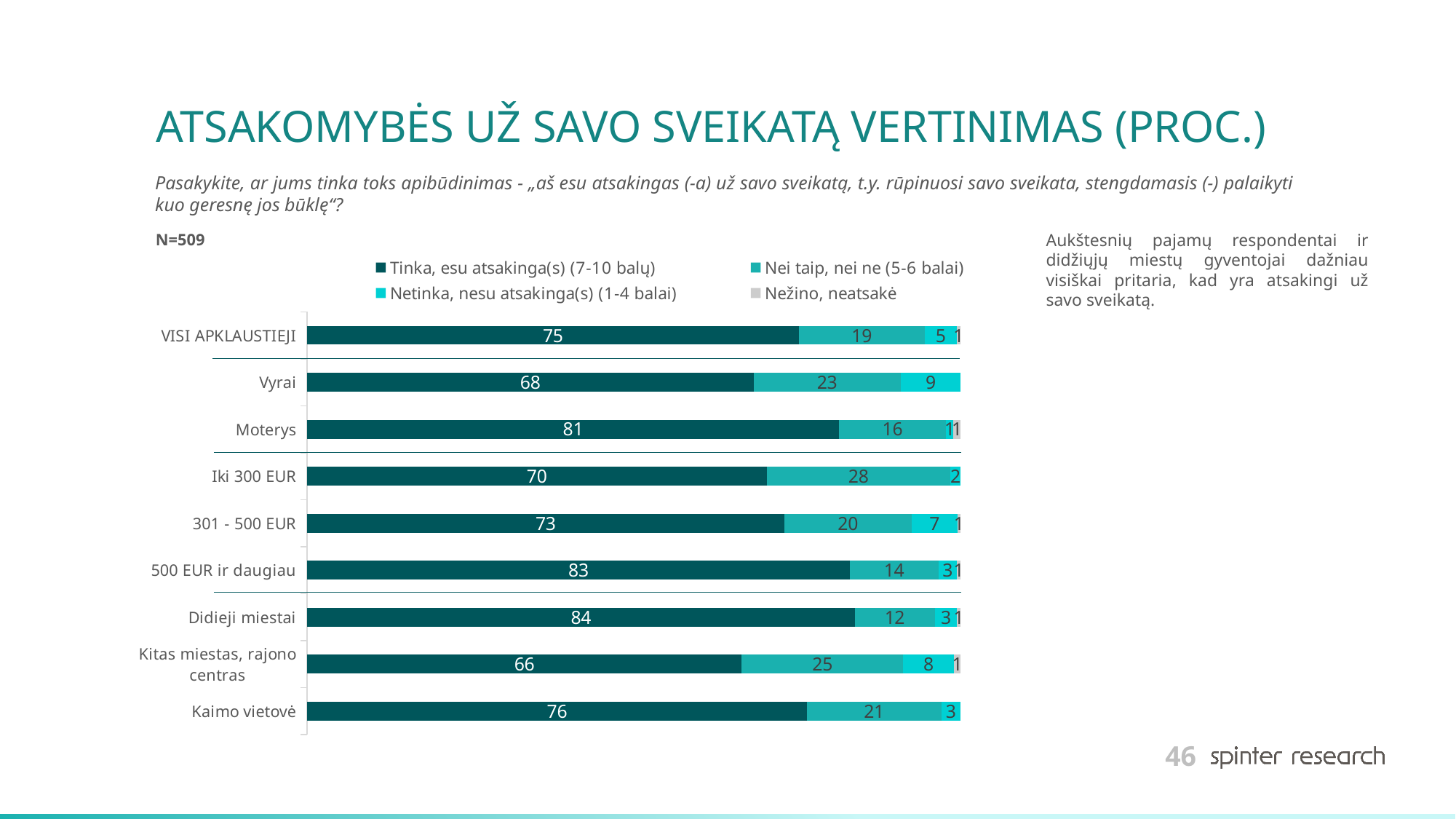
How many series does the legend list? 4 What is the difference between the "Tinka, esu atsakinga(s) (7-10 balų)" values for Moterys and Vyrai? 13 What is the sample size (N) shown on the slide? N=509 What is the value of "Netinka, nesu atsakinga(s) (1-4 balai)" for Vyrai? 9 Which category has the lowest value for "Tinka, esu atsakinga(s) (7-10 balų)"? Kitas miestas, rajono centras Which category has the highest value for "Tinka, esu atsakinga(s) (7-10 balų)"? Didieji miestai What is the value of "Tinka, esu atsakinga(s) (7-10 balų)" for Didieji miestai? 84 Which has a larger "Nei taip, nei ne (5-6 balai)" value, Kaimo vietovė or 500 EUR ir daugiau? Kaimo vietovė What is the value of "Nei taip, nei ne (5-6 balai)" for Iki 300 EUR? 28 What kind of chart is shown on the slide? Stacked bar chart How many categories are shown on the chart? 9 What is the total of the stacked bar for 301 - 500 EUR? 101